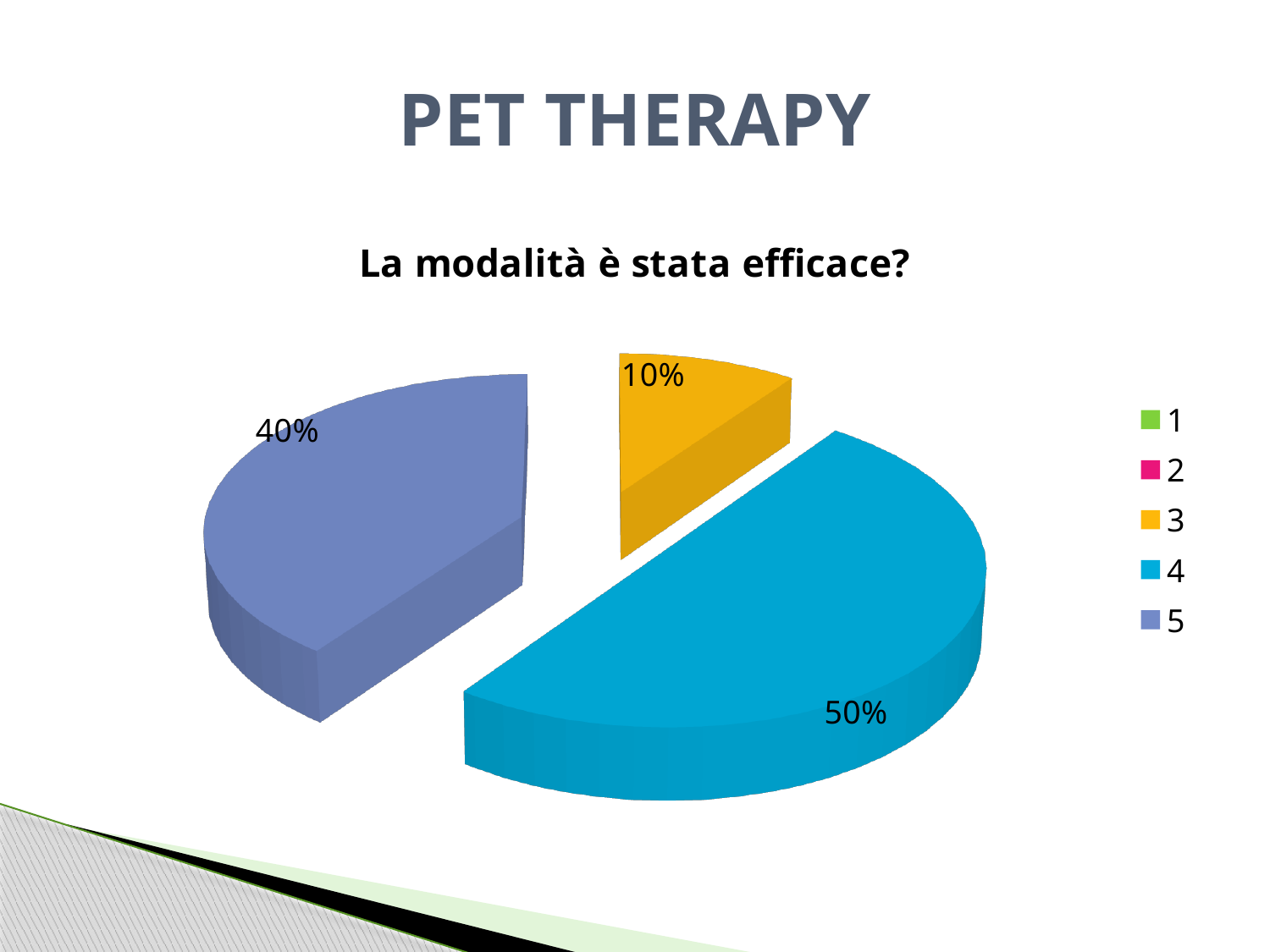
What is the difference in percentage points between category 4 and category 3? 40 What share of the pie does category 5 have? 40% What is the title of the chart? La modalità è stata efficace? What share of the pie does category 4 have? 50% How many entries does the legend list? 5 Which category has the largest slice of the pie? 4 What share of the pie does category 3 have? 10% Which category has the smallest visible slice of the pie? 3 How many slices are visible in the pie? 3 What kind of chart is shown on the slide? pie chart Which is larger, the slice for category 5 or the slice for category 3? 5 What is the difference in percentage points between category 5 and category 3? 30